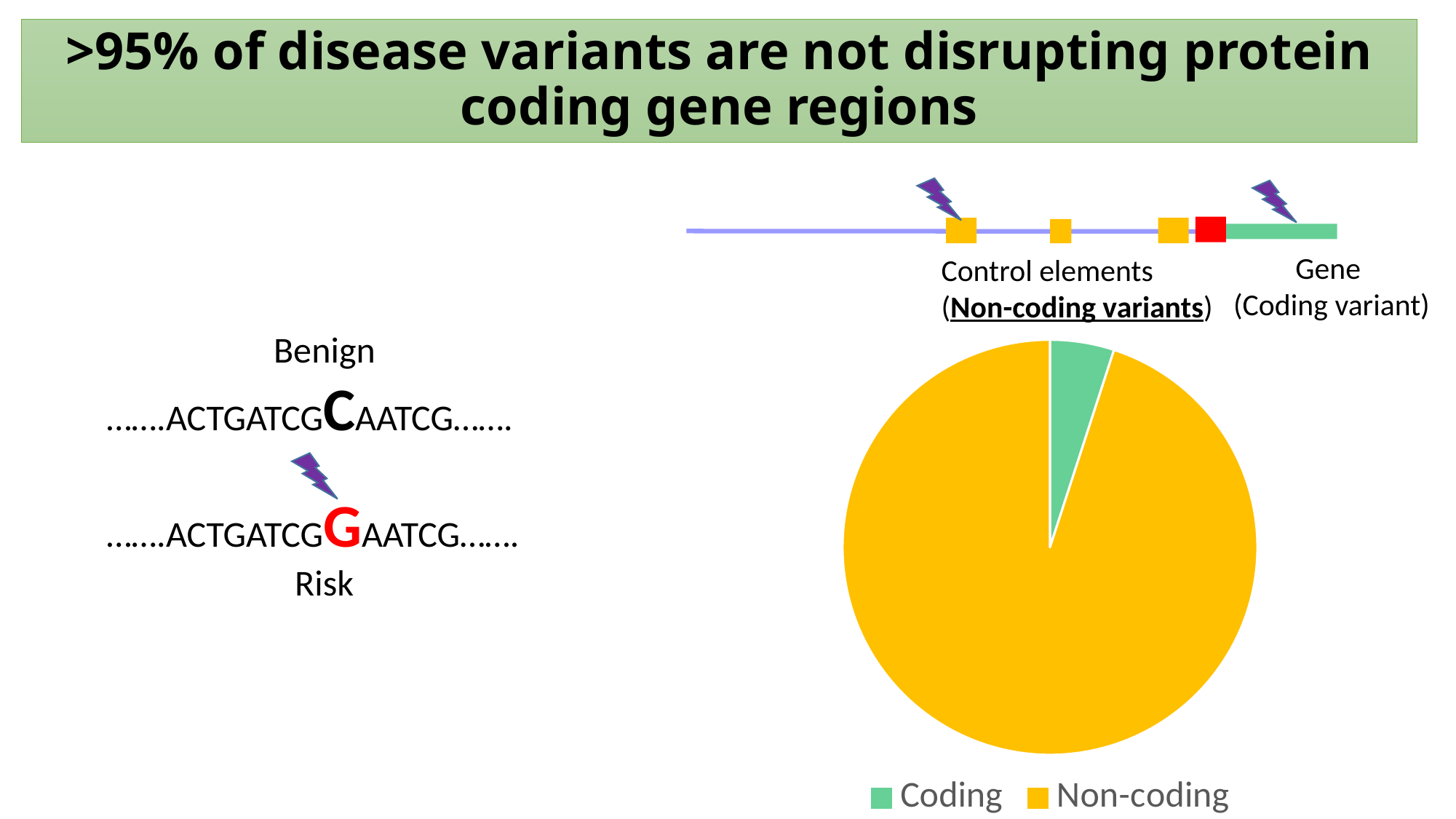
Which category takes up the smallest share of the pie chart? Coding Which slice is larger in the pie chart, Coding or Non-coding? Non-coding What colour is the Non-coding slice in the pie chart? yellow How many entries does the legend of the pie chart list? 2 How many slices does the pie chart have? 2 What colour is the Coding slice in the pie chart? green Which category takes up the largest share of the pie chart? Non-coding What kind of chart is shown on the slide? pie chart